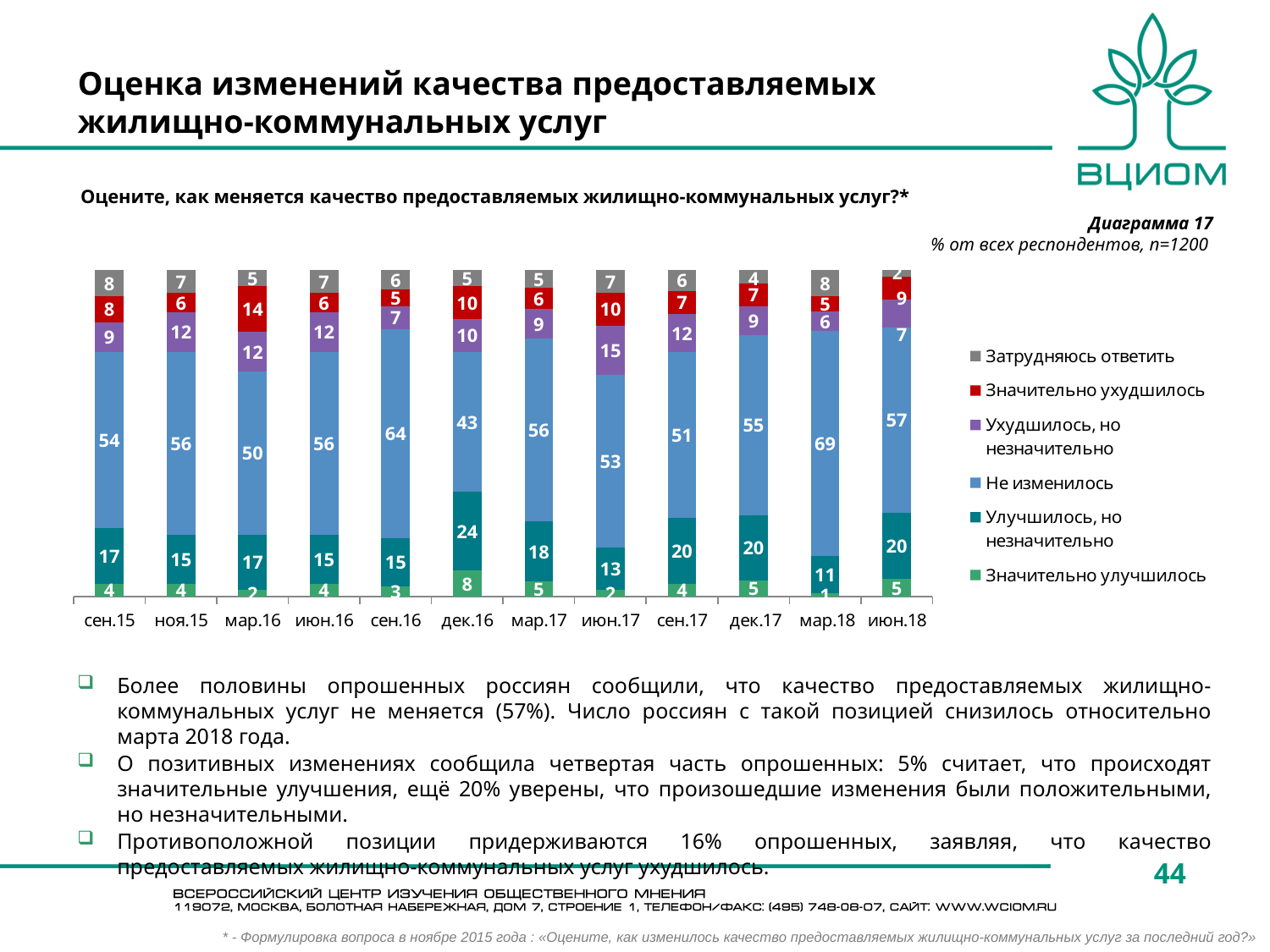
How many series does the chart legend list? 6 In which period is the value of 'Не изменилось' the highest? мар.18 What is the total of the stacked bar for сен.15? 100 In which period is the value of 'Не изменилось' the lowest? дек.16 What is the value of 'Значительно ухудшилось' for мар.16? 14 What is the value of 'Улучшилось, но незначительно' for дек.16? 24 Which series is shown in red in the chart legend? Значительно ухудшилось What is the value of 'Не изменилось' for июн.18? 57 What kind of chart is shown on the slide? Stacked bar chart What is the difference between the 'Не изменилось' values for мар.18 and июн.18? 12 How many time points (categories) are shown on the x axis of the chart? 12 Which is larger: the 'Ухудшилось, но незначительно' value for июн.17 or for сен.17? июн.17